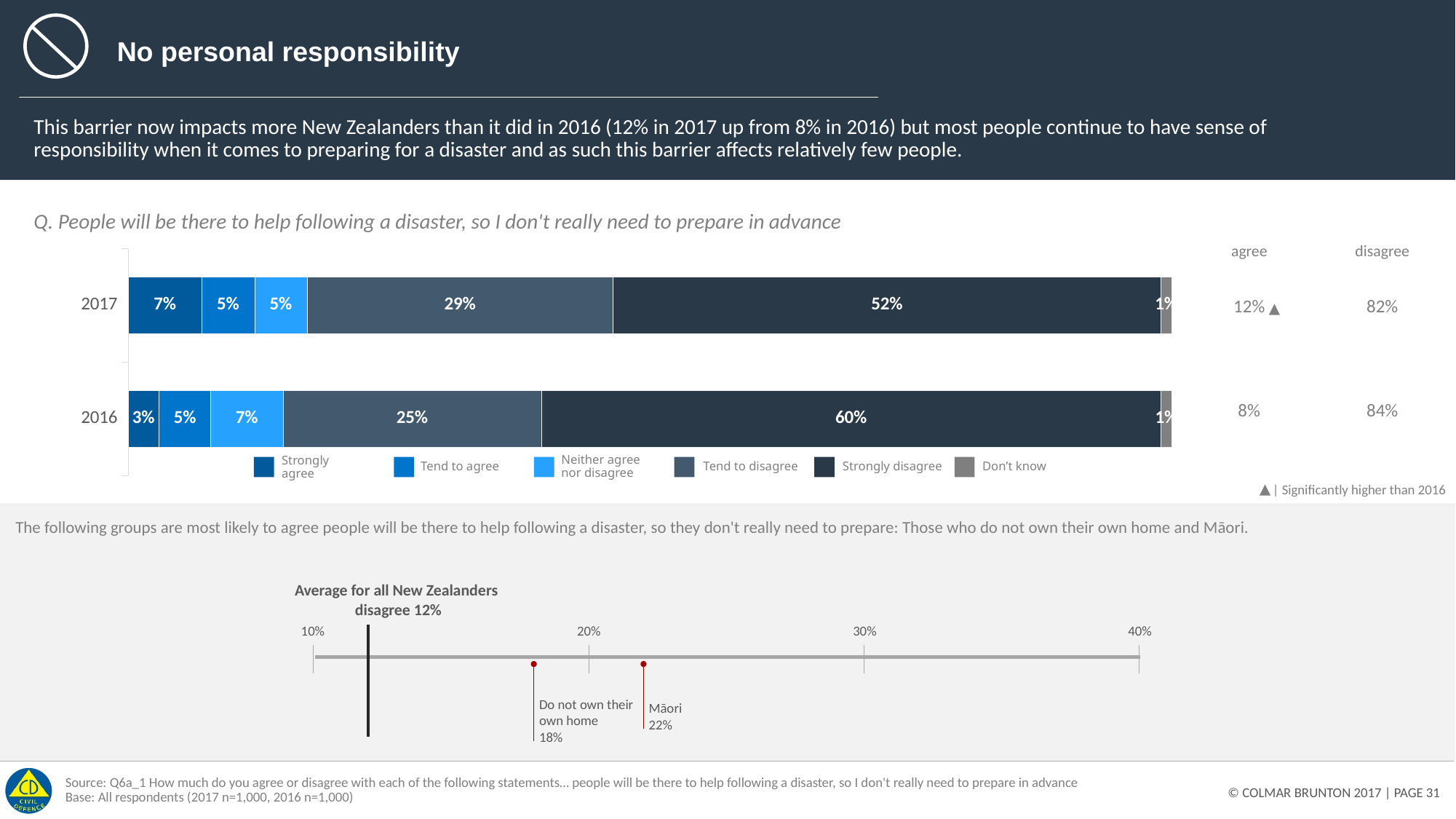
In the lower chart, what is the difference between the Māori value and the value for those who do not own their own home? 4 percentage points How many series does the legend of the stacked bar chart list? 6 In the lower chart of groups most likely to agree, what is the value for those who do not own their own home? 18% In the stacked bar chart, what percentage of respondents in 2017 answered 'Don't know'? 1% In the stacked bar chart, which year has the larger 'Tend to disagree' share, 2017 or 2016? 2017 In the stacked bar chart, what is the combined 'agree' total shown for 2017? 12% In the stacked bar chart, what percentage of respondents in 2017 strongly disagreed with the statement? 52% In the stacked bar chart, what percentage of respondents in 2016 strongly agreed with the statement? 3% In the stacked bar chart, what is the difference between the 'Strongly disagree' share in 2016 and in 2017? 8 percentage points What kind of chart is used to show the 2017 and 2016 responses? Stacked bar chart How many years (bars) are shown in the stacked bar chart? 2 In the lower chart of groups most likely to agree, what is the value for Māori? 22%